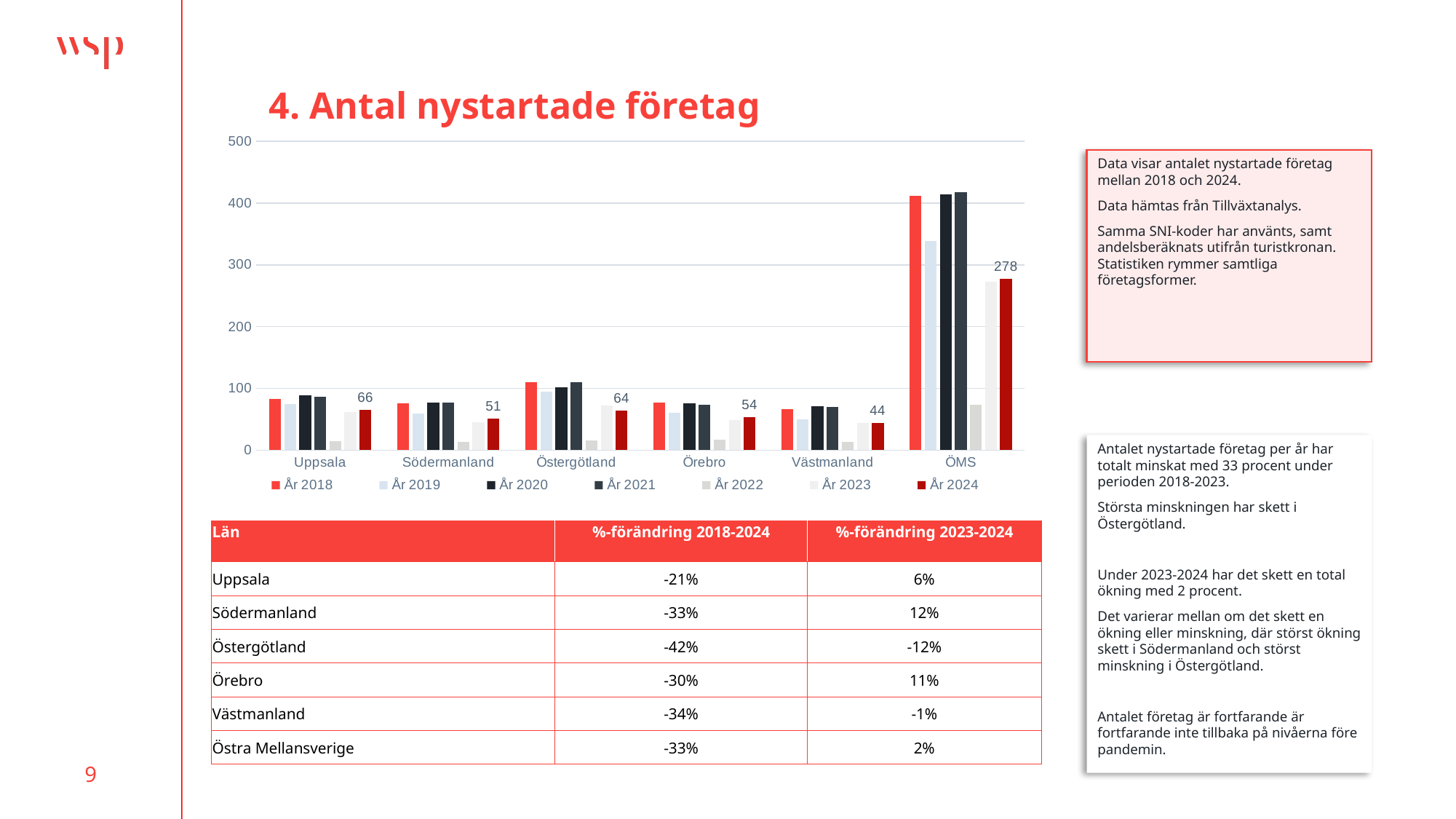
What is the difference between the År 2024 values for ÖMS and Uppsala? 212 Is the value for År 2018 in ÖMS greater or less than 400? greater How many categories are shown on the x axis of the chart? 6 How many series does the legend list? 7 Which category has the lowest value for År 2024? Västmanland Is the value for År 2019 in ÖMS greater or less than 300? greater What is the value for År 2024 in ÖMS? 278 What is the value for År 2024 in Uppsala? 66 Which is larger for År 2024: Östergötland or Örebro? Östergötland Which category has the highest value for År 2024? ÖMS What kind of chart is shown on the slide? Bar chart What is the value for År 2024 in Västmanland? 44